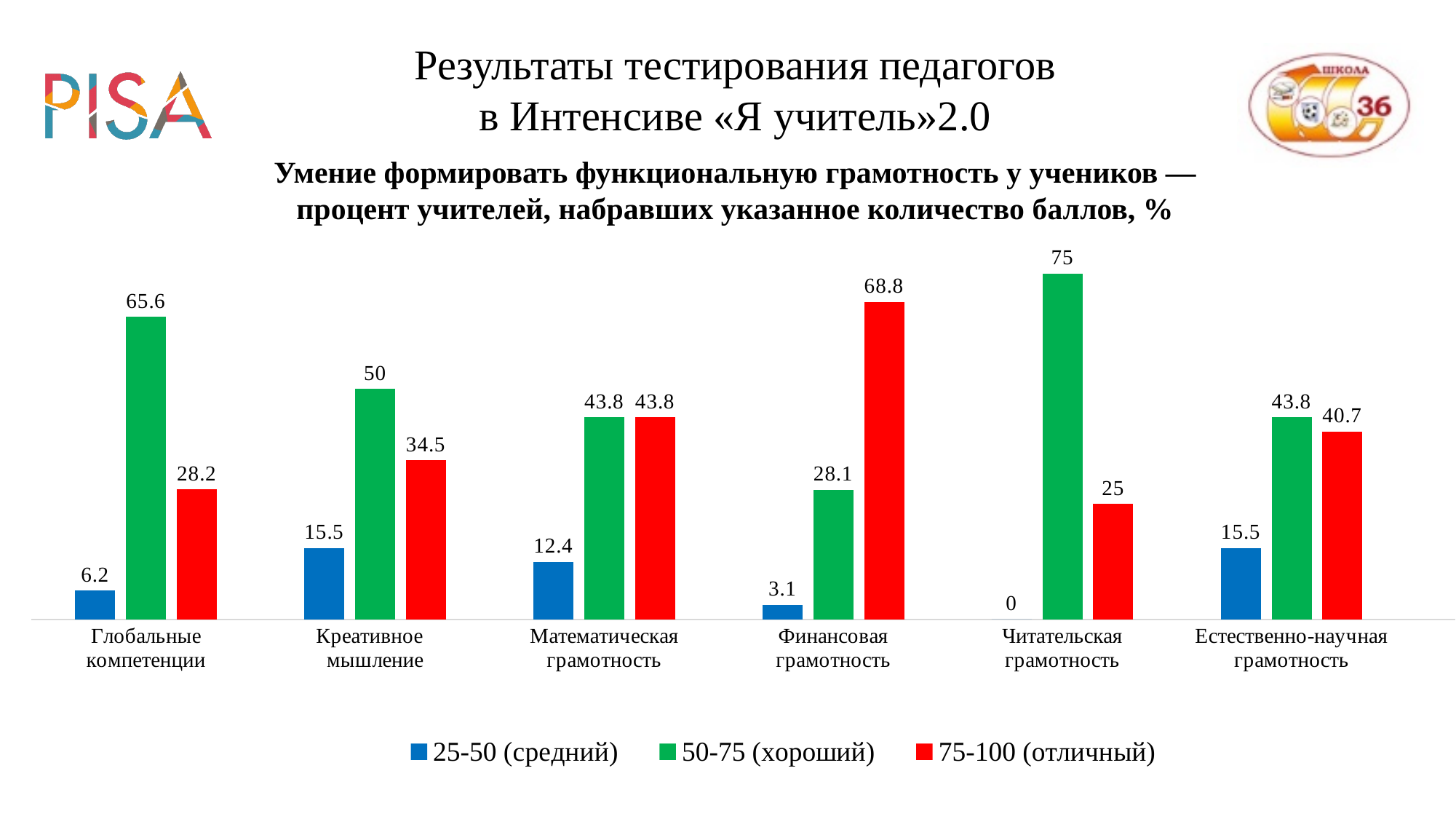
What is the value for Финансовая грамотность in the 75-100 (отличный) series? 68.8 What is the difference between the 50-75 (хороший) and 75-100 (отличный) values for Глобальные компетенции? 37.4 Which colour represents the 75-100 (отличный) series? Red How many categories are shown on the x axis? 6 Which is larger for Креативное мышление: the 50-75 (хороший) value or the 75-100 (отличный) value? 50-75 (хороший) What is the value for Читательская грамотность in the 50-75 (хороший) series? 75 Which category has the lowest value in the 25-50 (средний) series? Читательская грамотность Which category has the highest value in the 50-75 (хороший) series? Читательская грамотность What is the total of the three series values for Математическая грамотность? 100 What is the value for Глобальные компетенции in the 25-50 (средний) series? 6.2 How many series does the legend list? 3 What kind of chart is shown on the slide? Bar chart